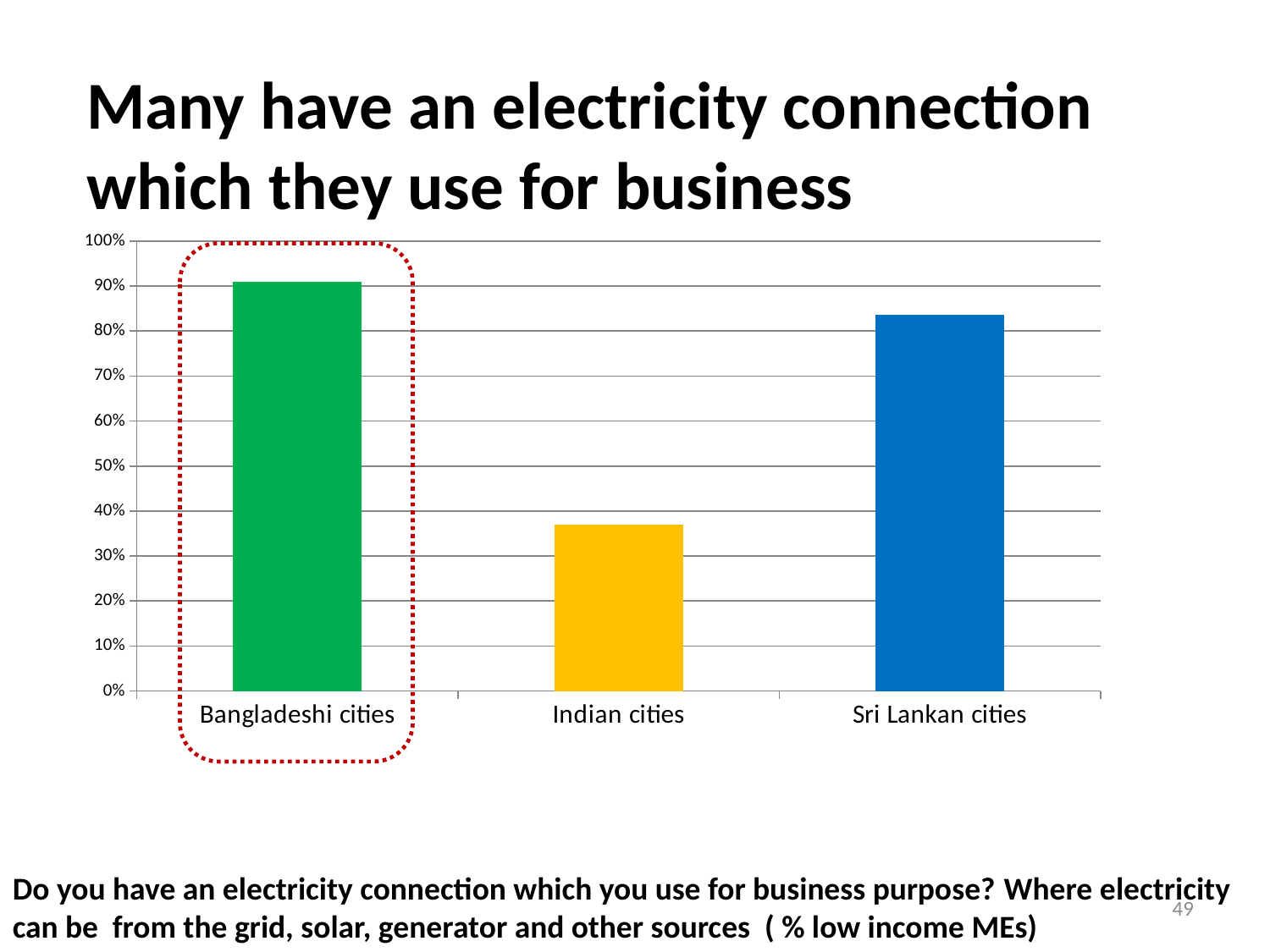
Which category has the highest value? Bangladeshi cities Is the value for Sri Lankan cities greater or less than 90%? less Is the value for Bangladeshi cities greater or less than 80%? greater Which category has the lowest value? Indian cities How many categories are plotted on the chart? 3 Which is larger, the value for Indian cities or the value for Sri Lankan cities? Sri Lankan cities What colour is the bar for Indian cities? yellow Is the value for Indian cities greater or less than 40%? less Which is larger, the value for Bangladeshi cities or the value for Indian cities? Bangladeshi cities Which category's bar is enclosed by a red dotted outline? Bangladeshi cities What kind of chart is shown on the slide? bar chart